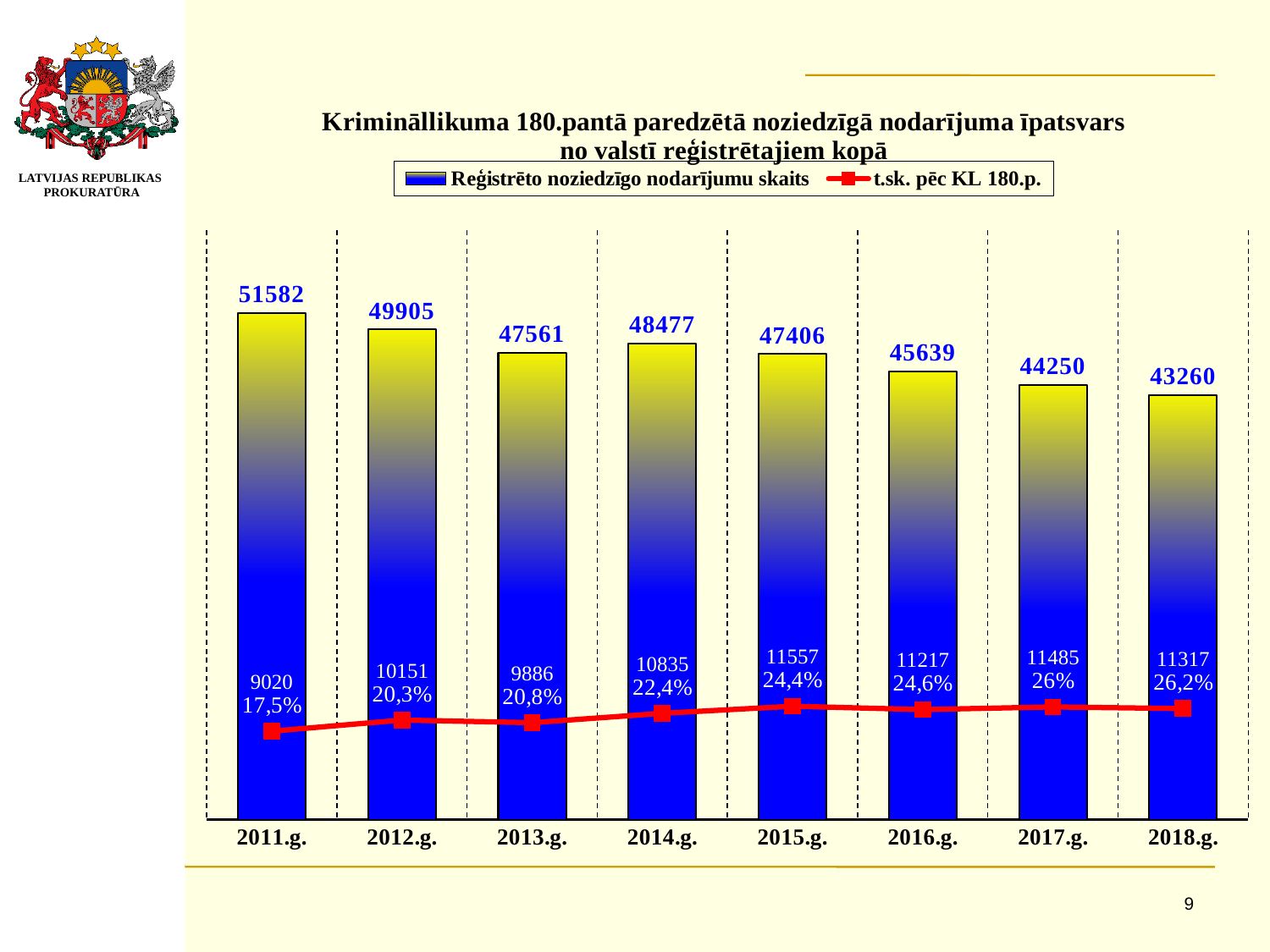
How many series does the legend list? 2 Which year has the lowest value of 'Reģistrēto noziedzīgo nodarījumu skaits'? 2018.g. How many years are shown on the x axis? 8 What is the count labelled for 't.sk. pēc KL 180.p.' in 2015.g.? 11557 Which year has the lowest count for 't.sk. pēc KL 180.p.'? 2011.g. Which is larger, the 'Reģistrēto noziedzīgo nodarījumu skaits' value for 2013.g. or for 2014.g.? 2014.g. What is the value of 'Reģistrēto noziedzīgo nodarījumu skaits' for 2011.g.? 51582 What is the value of 'Reģistrēto noziedzīgo nodarījumu skaits' for 2018.g.? 43260 What is the overall trend of 'Reģistrēto noziedzīgo nodarījumu skaits' from 2011.g. to 2018.g.? falling What is the difference between the 'Reģistrēto noziedzīgo nodarījumu skaits' values for 2011.g. and 2018.g.? 8322 What percentage is shown for 't.sk. pēc KL 180.p.' in 2018.g.? 26,2% Which year has the highest value of 'Reģistrēto noziedzīgo nodarījumu skaits'? 2011.g.